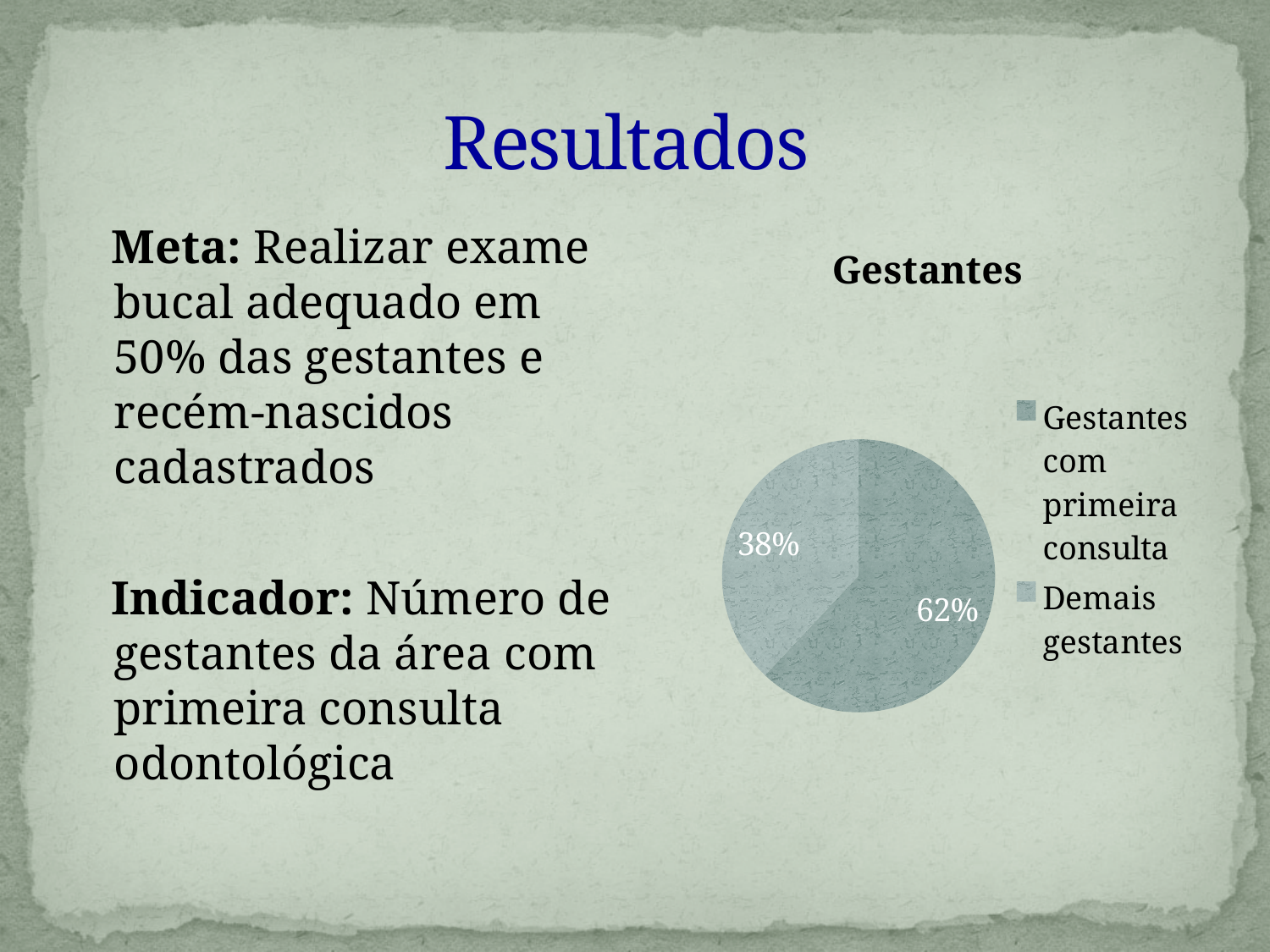
How many entries does the chart legend list? 2 What kind of chart is shown on the slide? pie chart Which slice of the pie is the smallest? Demais gestantes Which is larger: the slice for 'Gestantes com primeira consulta' or the slice for 'Demais gestantes'? Gestantes com primeira consulta What is the difference in percentage points between the two slices of the pie? 24 How many slices does the pie chart have? 2 Which slice of the pie is the largest? Gestantes com primeira consulta What share of the pie is labelled for 'Demais gestantes'? 38% What is the title of the chart? Gestantes What are the two legend entries of the chart? Gestantes com primeira consulta; Demais gestantes What share of the pie is labelled for 'Gestantes com primeira consulta'? 62%